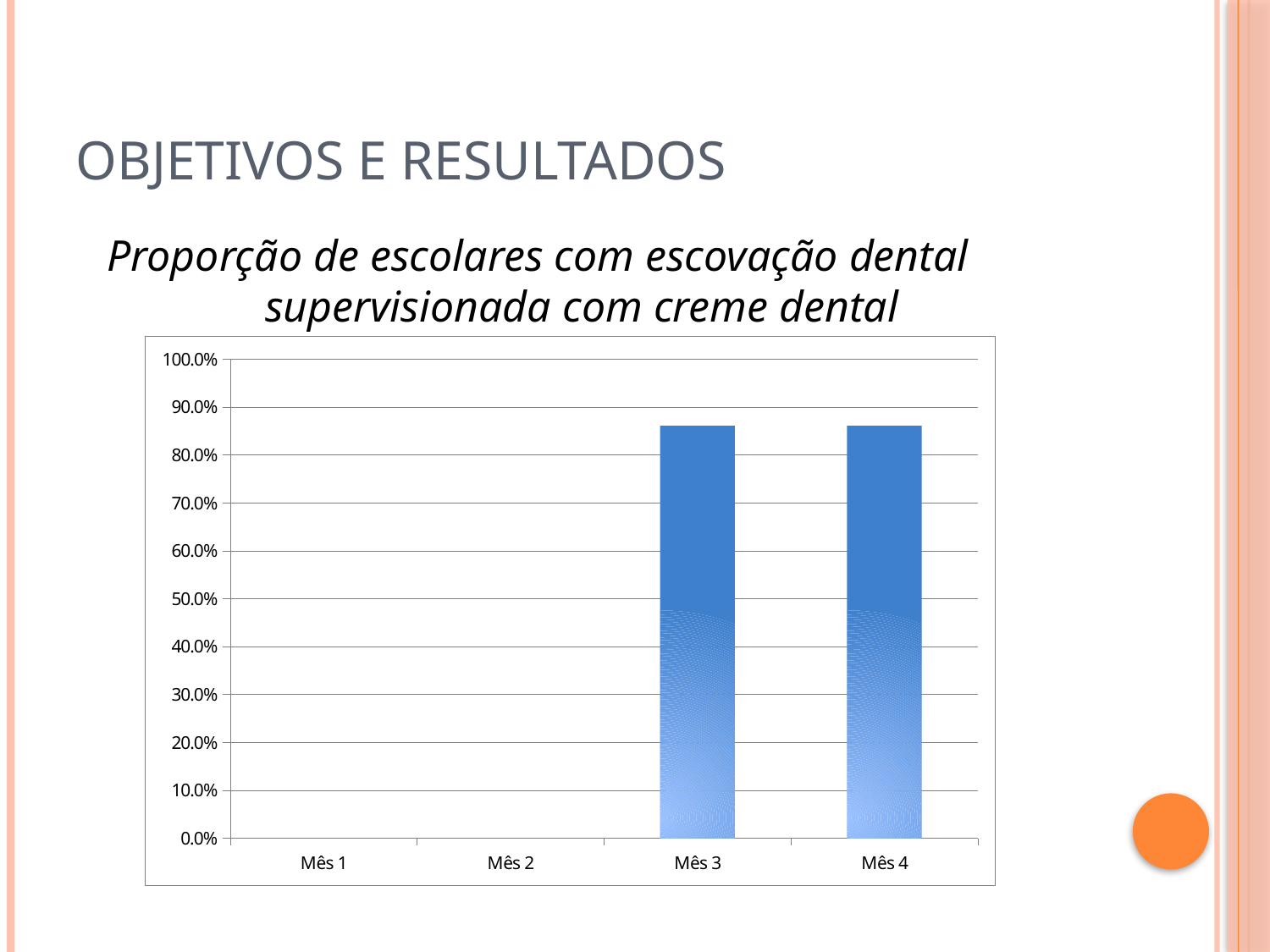
Do the values rise or fall from Mês 2 to Mês 3? rise Is the value for Mês 4 greater or less than 90.0%? less Is the value for Mês 3 greater or less than 50.0%? greater Which is larger, the value for Mês 1 or the value for Mês 3? Mês 3 What is the highest value shown on the y axis of the chart? 100.0% Which is larger, the value for Mês 2 or the value for Mês 4? Mês 4 What kind of chart is shown on the slide? bar chart What is the value shown for Mês 1? 0.0% What is the title of the chart? Proporção de escolares com escovação dental supervisionada com creme dental How many categories are shown on the x axis of the chart? 4 Is the value for Mês 3 greater or less than 80.0%? greater